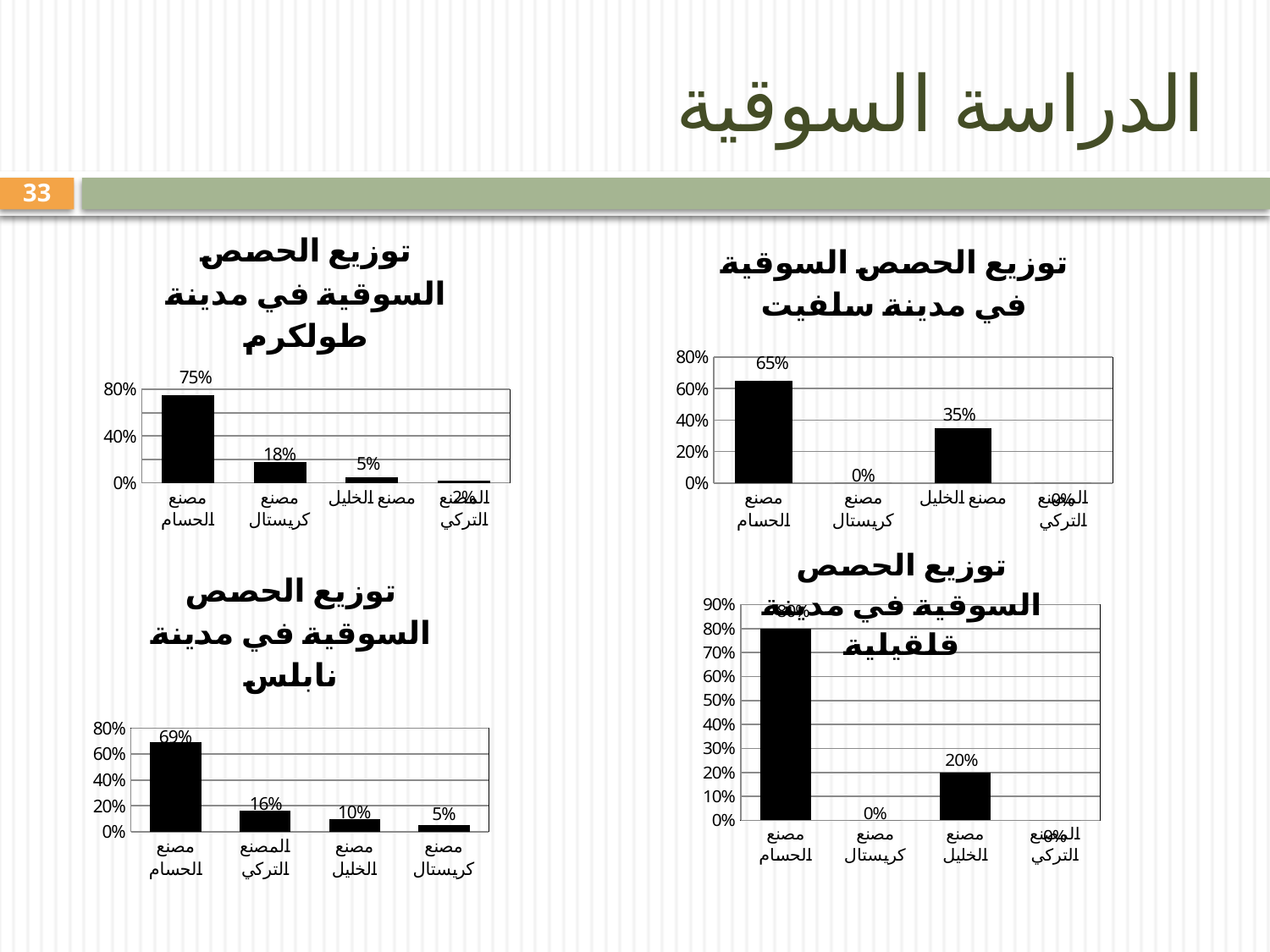
In the chart for مدينة سلفيت (top right), what is the market share of مصنع الحسام? 65% In the chart for مدينة طولكرم (top left), what is the market share of مصنع كريستال? 18% In the chart for مدينة نابلس (bottom left), which is larger: the share of مصنع الخليل or the share of مصنع كريستال? مصنع الخليل In the chart for مدينة طولكرم (top left), which factory has the highest market share? مصنع الحسام How many factories are shown on the x axis of the chart for مدينة سلفيت (top right)? 4 What type of chart is used for مدينة نابلس (bottom left)? bar chart In the chart for مدينة قلقيلية (bottom right), is the value for مصنع الحسام greater or less than 70%? greater In the chart for مدينة نابلس (bottom left), which factory has the lowest market share? مصنع كريستال In the chart for مدينة نابلس (bottom left), what is the market share of المصنع التركي? 16% In the chart for مدينة قلقيلية (bottom right), what is the market share of مصنع الخليل? 20% In the chart for مدينة سلفيت (top right), what is the market share of مصنع الخليل? 35% In the chart for مدينة طولكرم (top left), what is the difference between the shares of مصنع الحسام and مصنع كريستال? 57%